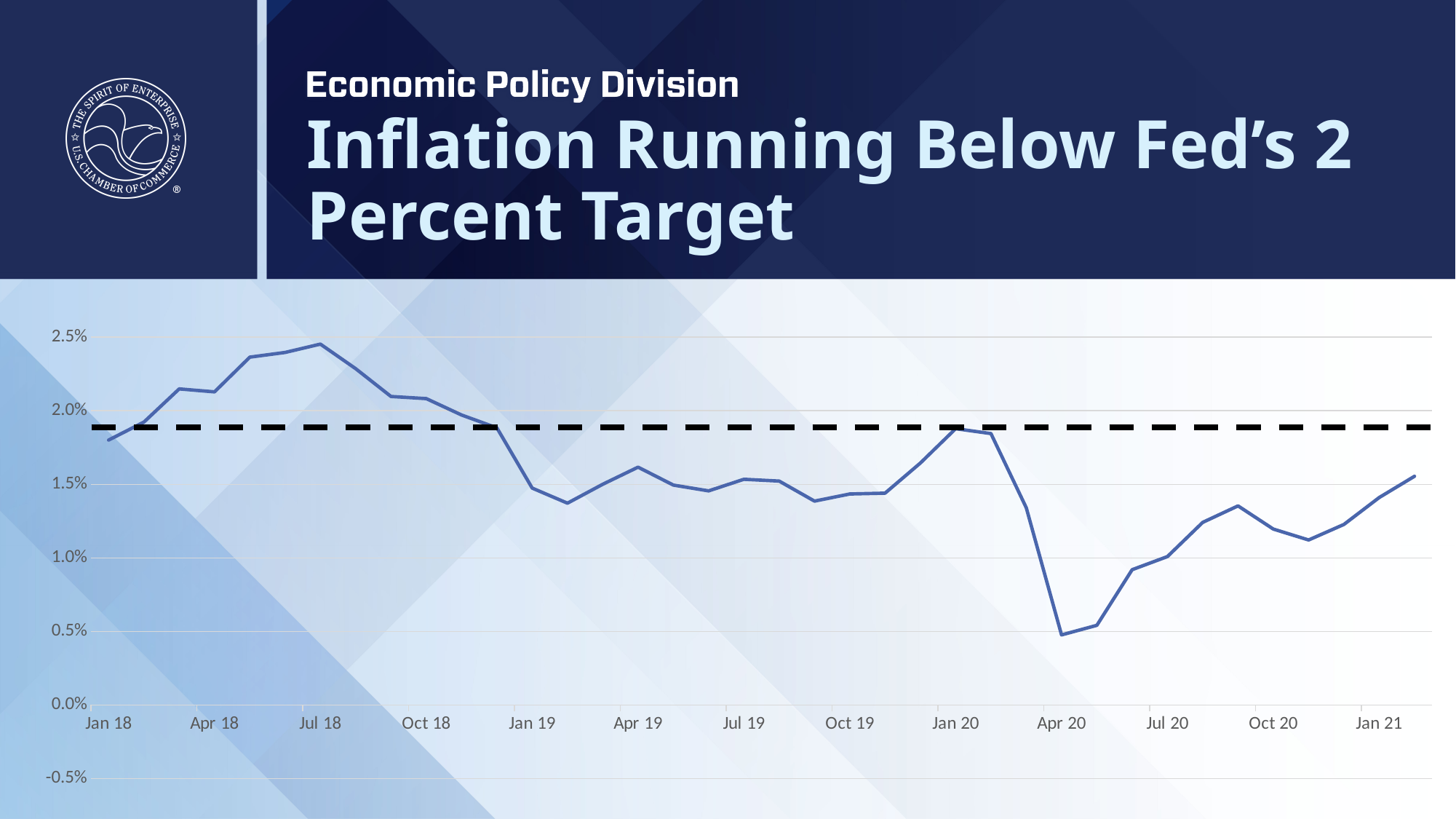
What is the title of the slide's chart? Inflation Running Below Fed's 2 Percent Target Do the values rise or fall from Apr 20 to Jan 21? rise How many month labels are shown on the x axis? 13 Which labeled month on the x axis has the highest value? Jul 18 Is the value for Jan 20 greater or less than 1.5%? greater Is the value for Jan 19 greater or less than 2.0%? less Is the value for Apr 20 greater or less than 1.0%? less Which labeled month on the x axis has the lowest value? Apr 20 Which is larger, the value for Jul 18 or the value for Apr 20? Jul 18 What kind of chart is shown on the slide? line chart